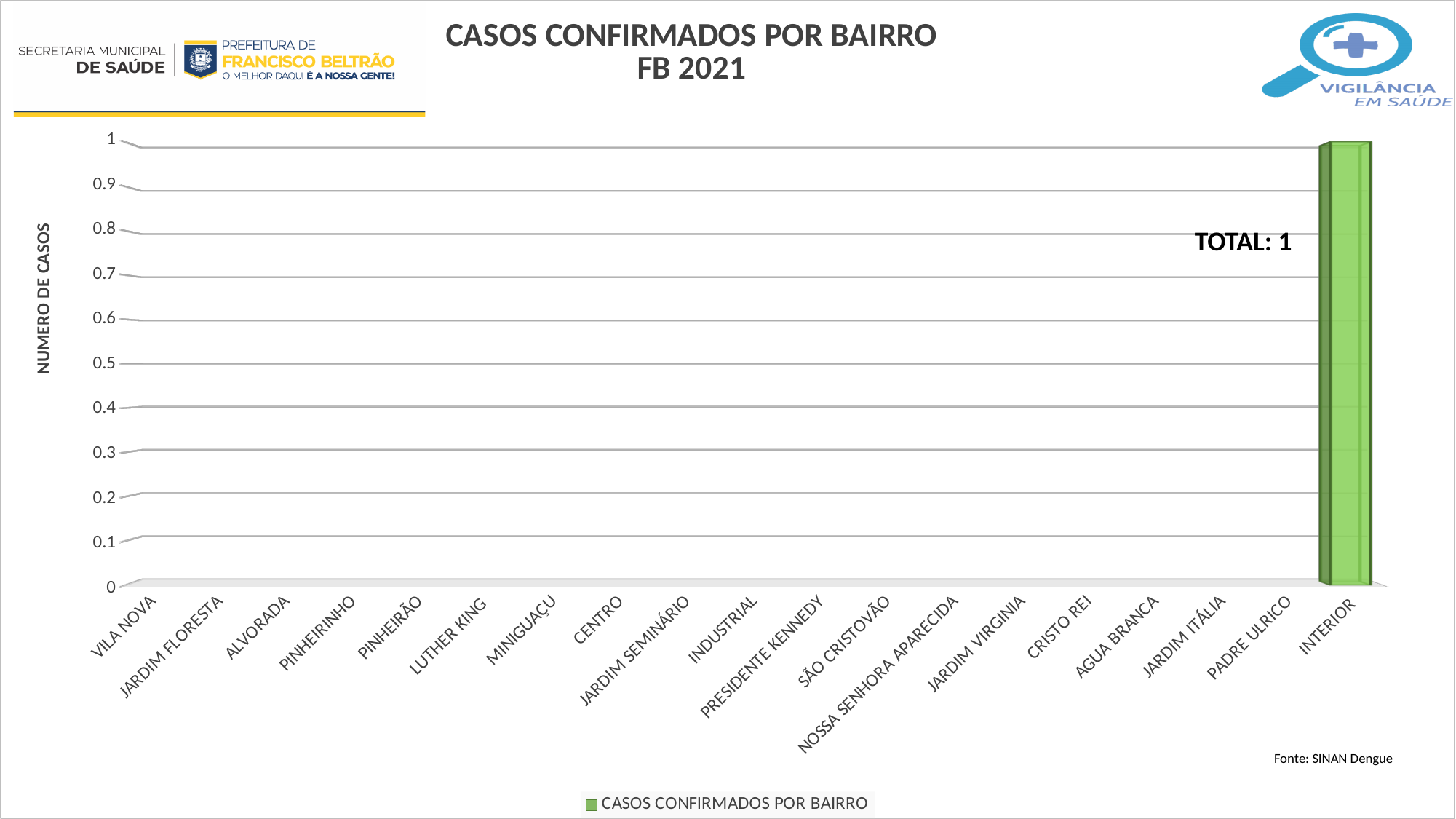
How many bairros (categories) are listed on the x axis? 19 What is the label of the y axis? NUMERO DE CASOS What is the total number of confirmed cases shown on the chart? 1 What is the number of confirmed cases for INTERIOR? 1 Which has more confirmed cases, INTERIOR or CENTRO? INTERIOR Which bairro has the highest number of confirmed cases? INTERIOR Is the value for INTERIOR greater or less than 0.5? greater What kind of chart is shown on the slide? bar chart How many series does the legend list? 1 What is the title of the chart? CASOS CONFIRMADOS POR BAIRRO FB 2021